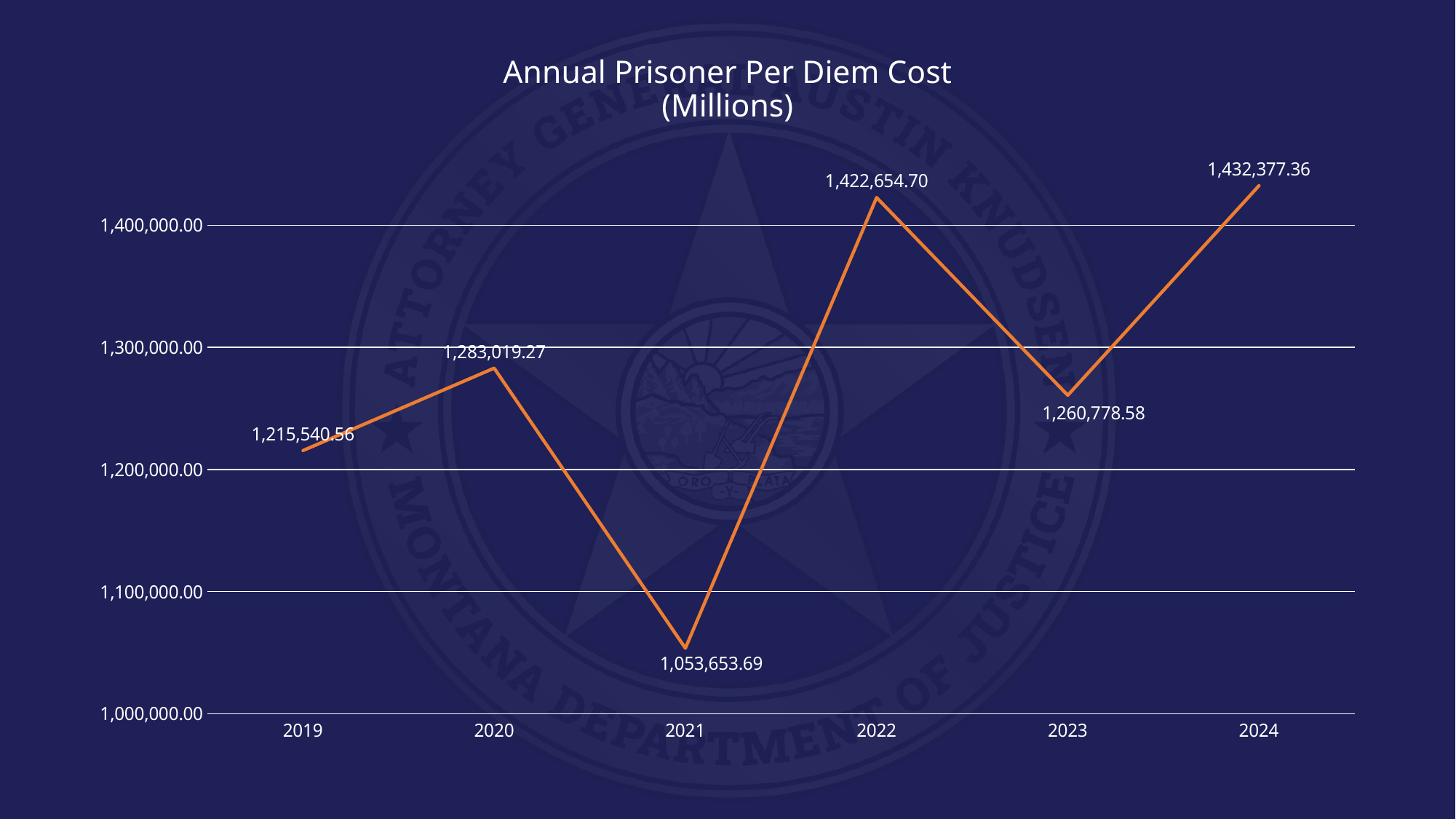
What is the value for 2021? 1,053,653.69 What is the value for 2023? 1,260,778.58 What is the difference between the values for 2022 and 2021? 369,001.01 Which is larger, the value for 2020 or the value for 2023? 2020 What kind of chart is shown? line chart What is the title of the chart? Annual Prisoner Per Diem Cost (Millions) What is the difference between the values for 2020 and 2019? 67,478.71 Is the value for 2023 greater or less than 1,200,000.00? greater What is the value for 2019? 1,215,540.56 How many years are plotted on the chart? 6 Which year has the lowest value? 2021 Which year has the highest value? 2024